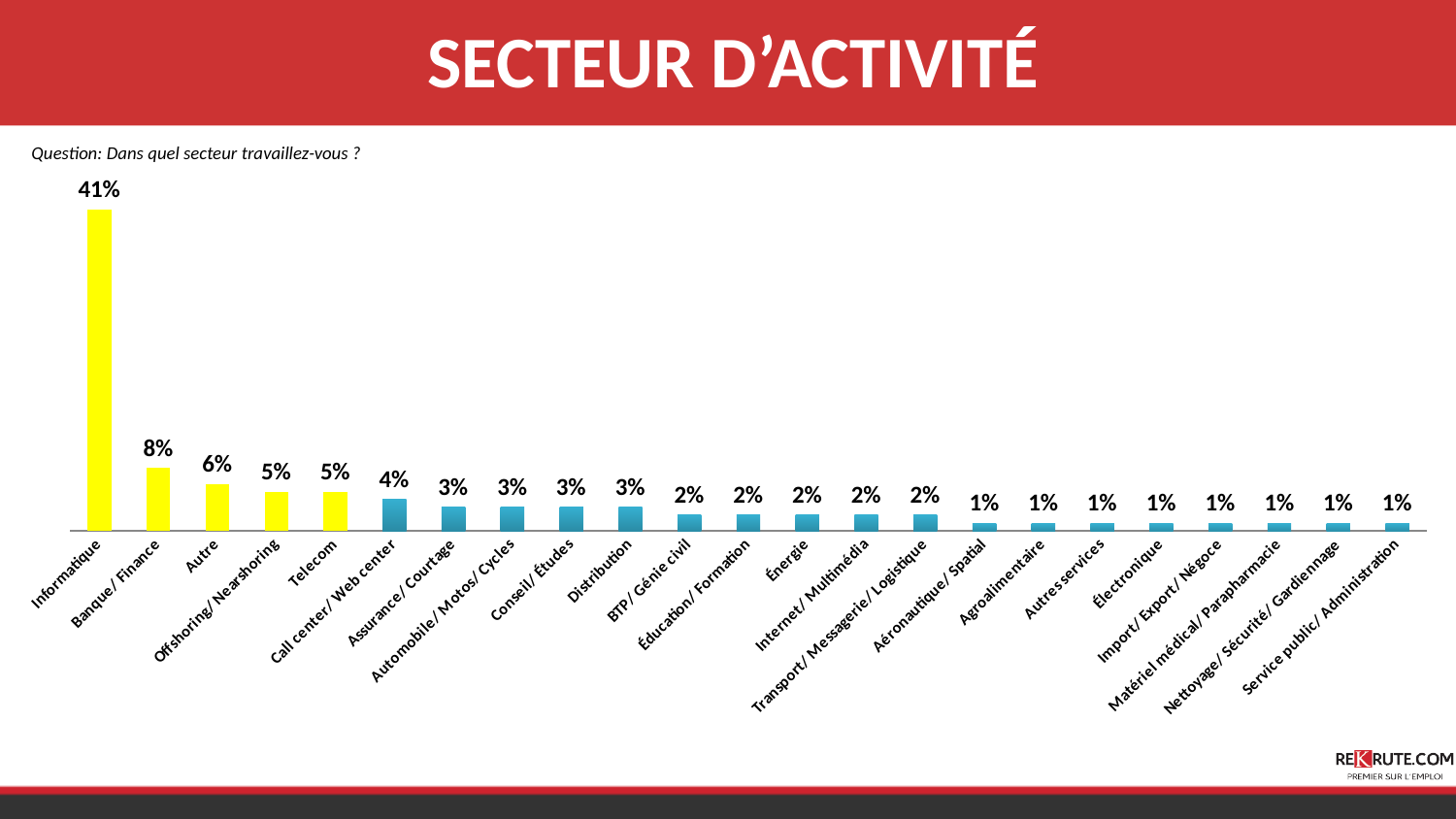
What is the difference between the values for Autre and Telecom? 1% How many sectors are shown on the chart? 23 Which sector has the highest percentage? Informatique What percentage is shown for Call center/ Web center? 4% What is the value shown for Banque/ Finance? 8% What type of chart is shown on the slide? Bar chart What colour are the bars for the five highest sectors? Yellow What percentage of respondents work in the Informatique sector? 41% What is the difference between the Informatique and Banque/ Finance percentages? 33% How many sectors have a value of 1%? 8 Which is larger, the value for Assurance/ Courtage or the value for Énergie? Assurance/ Courtage What is the value for Distribution? 3%